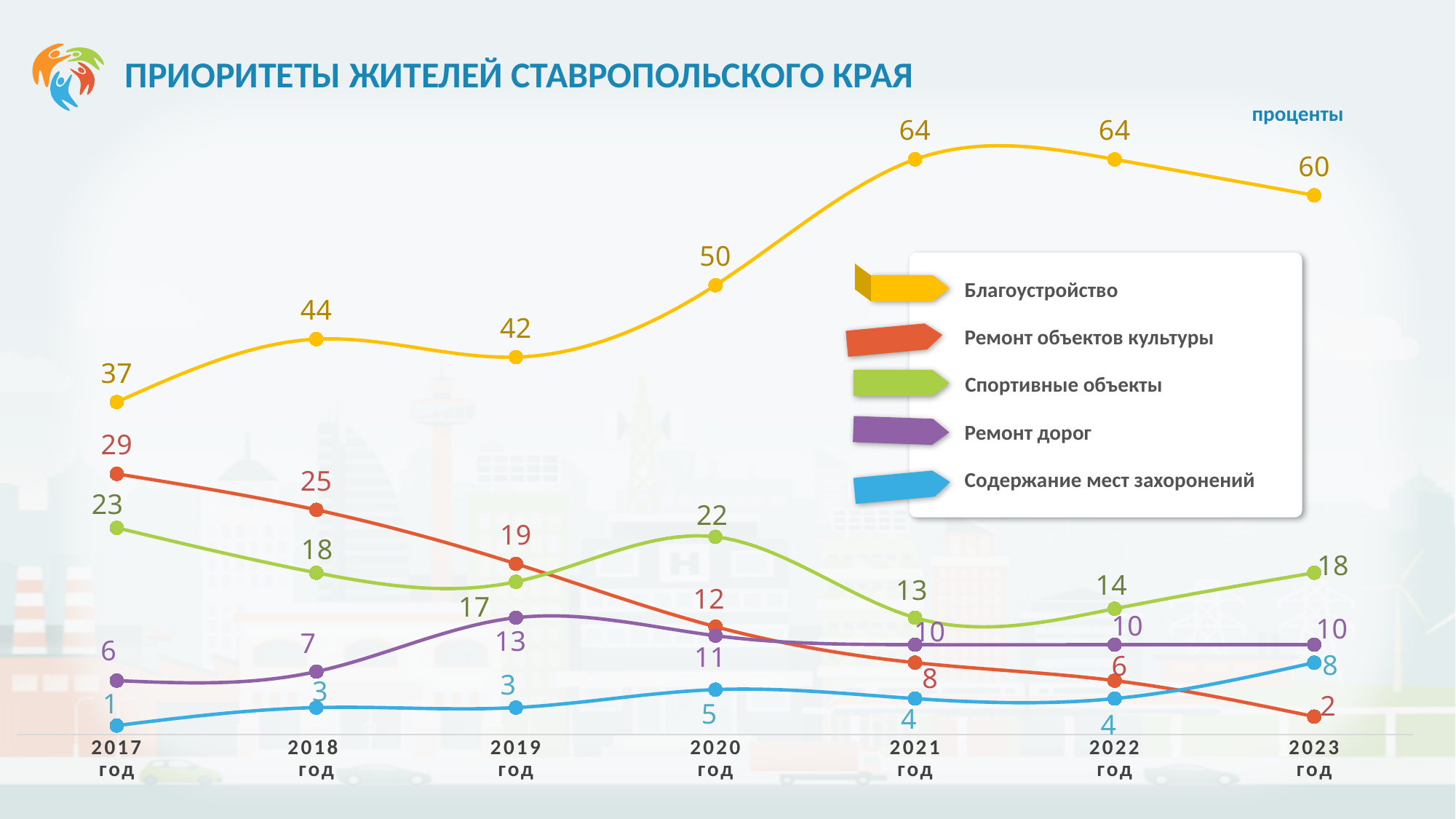
What is the value for Ремонт объектов культуры in 2023? 2 What kind of chart is shown on the slide? line chart What unit is indicated in the top right corner of the chart? проценты Which series has the highest value in 2021? Благоустройство What is the value for Благоустройство in 2020? 50 How many series does the legend list? 5 What is the value for Спортивные объекты in 2020? 22 Which is larger in 2019: Спортивные объекты or Ремонт дорог? Спортивные объекты How many years are plotted along the x axis? 7 Does the value for Ремонт объектов культуры rise or fall from 2017 to 2023? fall In which year does Благоустройство reach its lowest value? 2017 What is the difference between the Благоустройство values in 2021 and 2017? 27